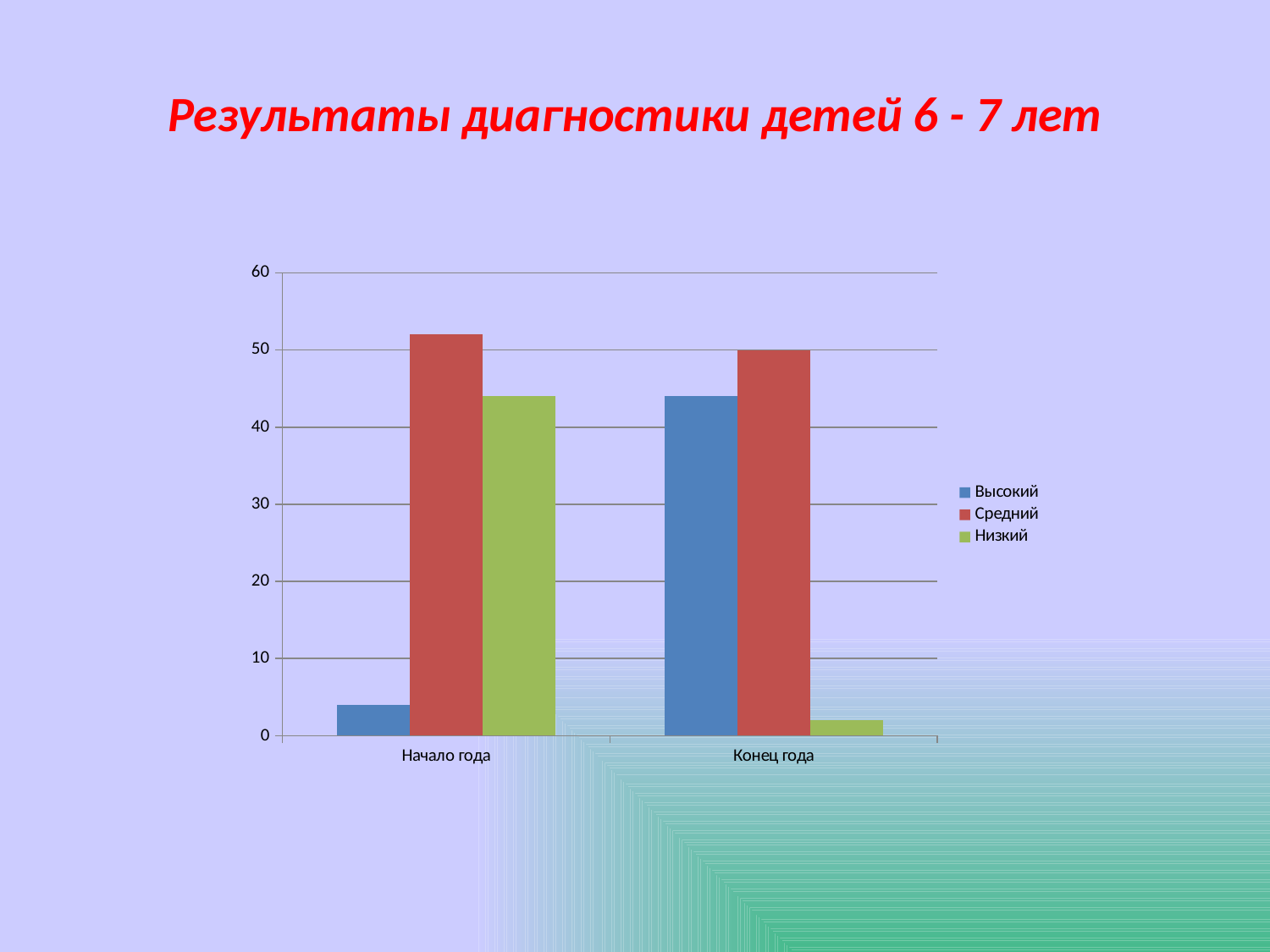
What kind of chart is shown on the slide? Bar chart Is the value for Высокий at Начало года greater or less than 10? less How many series does the legend list? 3 Which is larger: the Высокий value for Начало года or for Конец года? Конец года How many categories are shown on the x axis? 2 Is the value for Средний at Начало года greater or less than 50? greater Which series has the lowest value for Конец года? Низкий Is the value for Низкий at Конец года greater or less than 10? less Does the Низкий series rise or fall from Начало года to Конец года? Fall Which series has the highest value for Начало года? Средний What is the title of the slide? Результаты диагностики детей 6 - 7 лет Which series has the lowest value for Начало года? Высокий